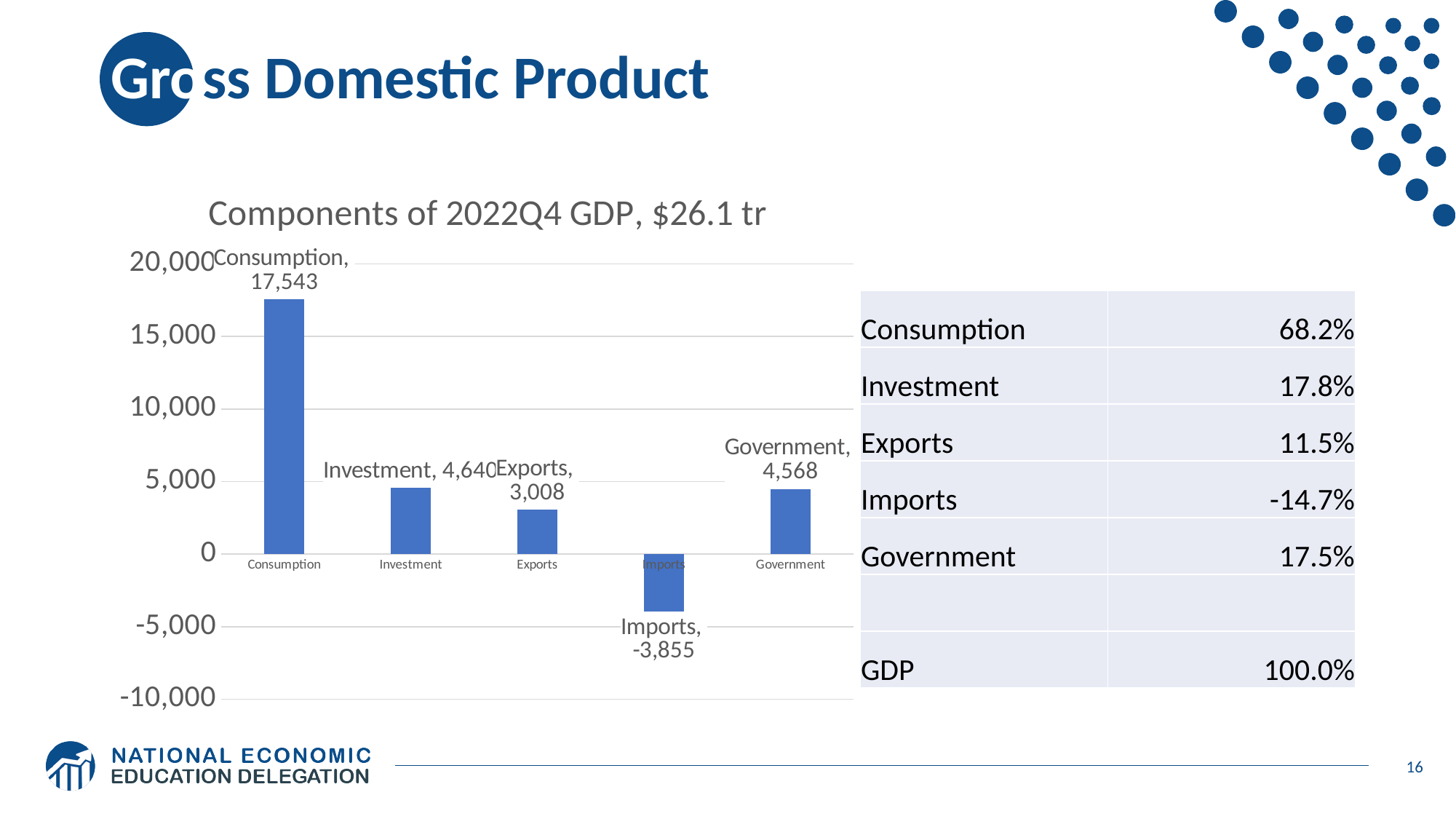
What is the value for Imports in the chart? -3,855 Which component has the highest value in the chart? Consumption What is the value for Consumption in the Components of 2022Q4 GDP chart? 17,543 How many components are plotted in the chart? 5 What is the value for Investment in the chart? 4,640 What is the difference between the Investment and Government values? 72 What is the difference between the Consumption and Investment values? 12,903 Which component has the lowest value in the chart? Imports What is the value for Government in the chart? 4,568 What is the title of the chart? Components of 2022Q4 GDP, $26.1 tr Which is larger, the value for Exports or the value for Government? Government Is the value for Consumption greater or less than 15,000? greater